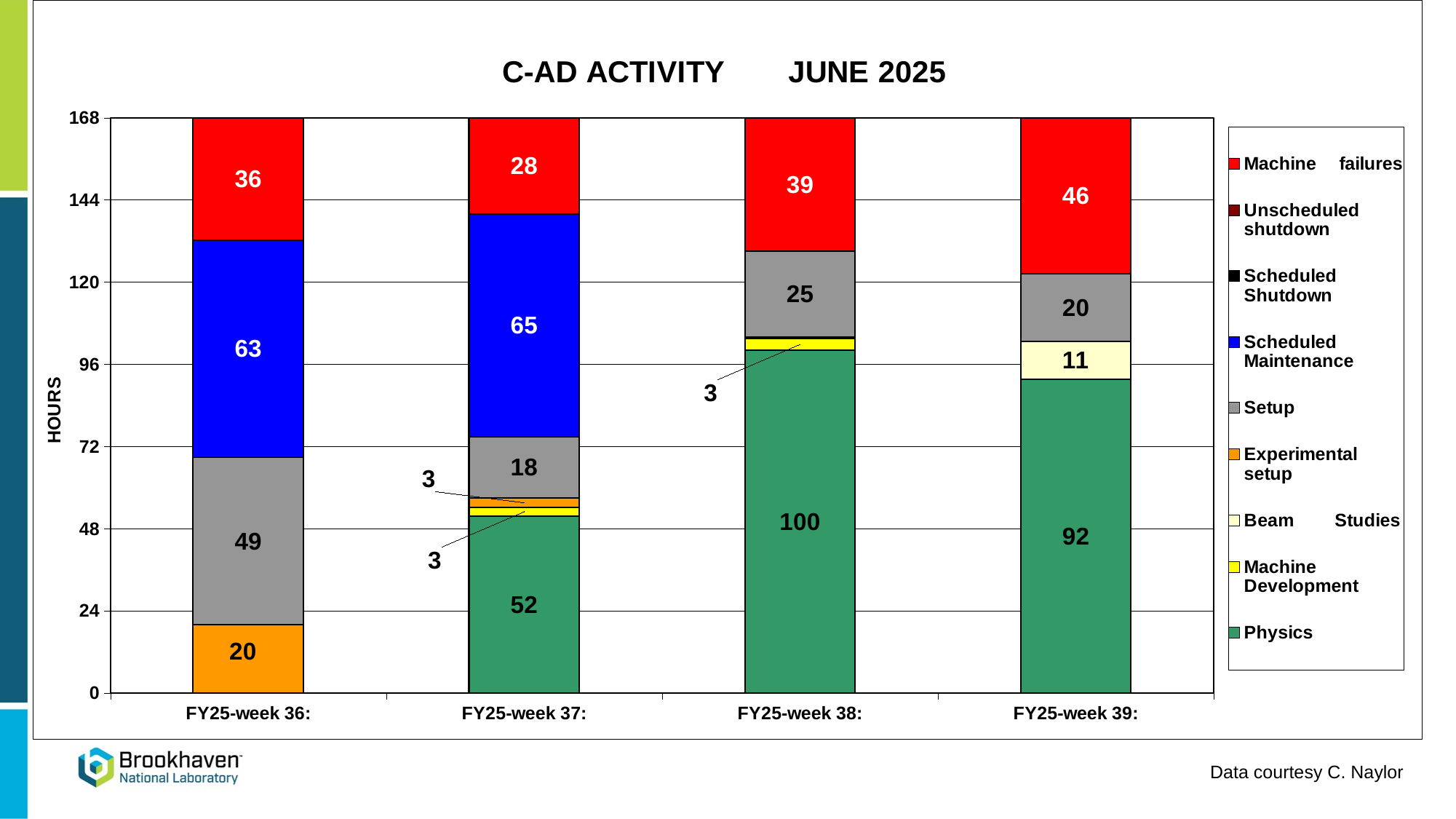
How many series does the legend list? 9 Which week has the larger Scheduled Maintenance value, FY25-week 36 or FY25-week 37? FY25-week 37 What is the total of the stacked bar for FY25-week 36? 168 What is the difference between the Setup values for FY25-week 36 and FY25-week 39? 29 How many hours of Physics are shown for FY25-week 38? 100 Which week has the highest Physics value? FY25-week 38 What is the Scheduled Maintenance value for FY25-week 37? 65 What is the value for Machine failures in FY25-week 39? 46 What kind of chart is shown on the slide? Stacked bar chart Which week has the lowest Machine failures value? FY25-week 37 What is the Beam Studies value for FY25-week 39? 11 How many weeks are shown on the x axis? 4